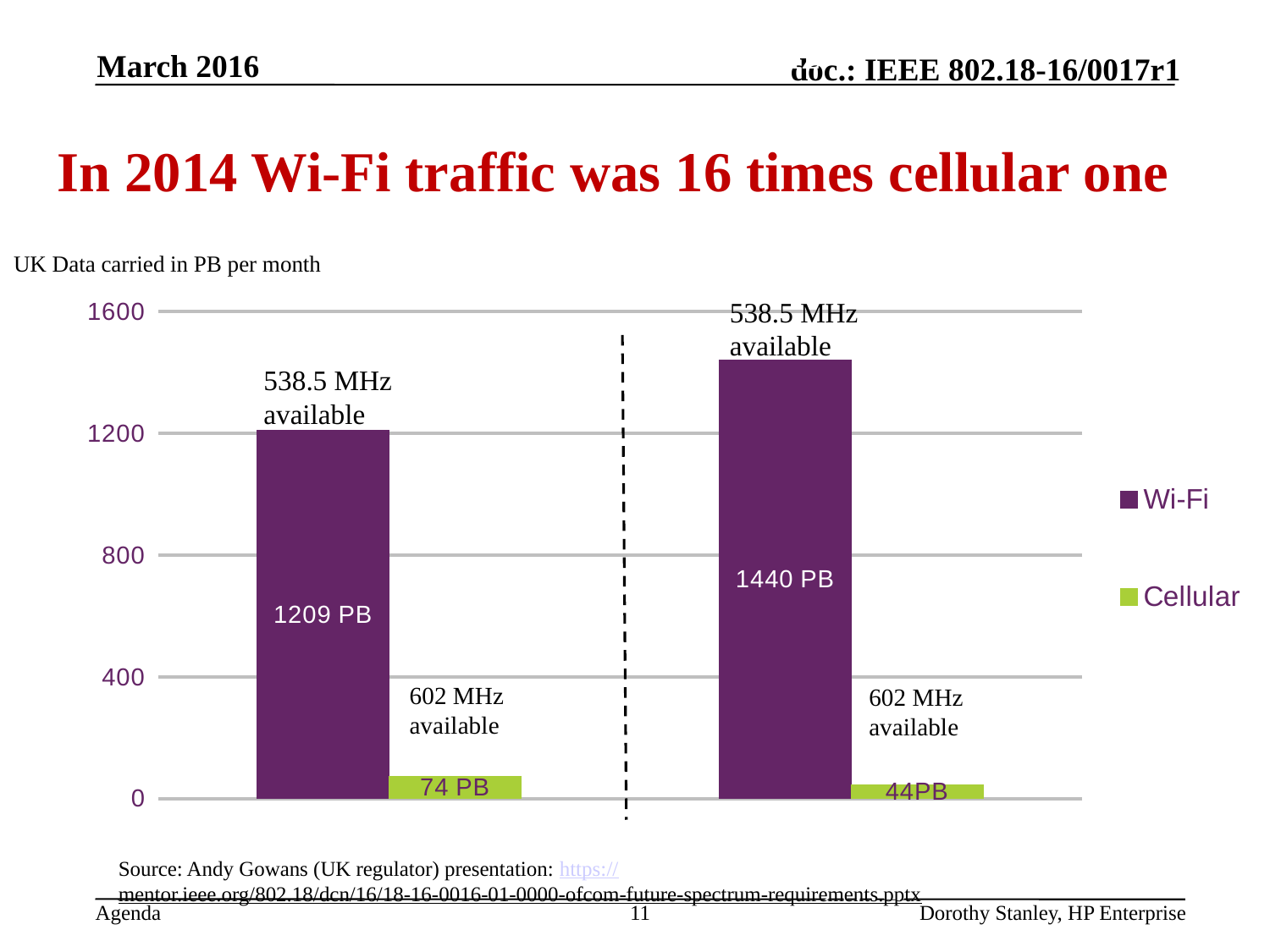
How many series does the chart legend list? 2 Is the Wi-Fi value in the left group greater or less than 1200? greater What is the Wi-Fi value shown on the left group of bars? 1209 PB What is the Wi-Fi value shown on the right group of bars? 1440 PB What are the two series named in the chart legend? Wi-Fi and Cellular Which bar in the chart has the highest value? Wi-Fi in the right group (1440 PB) What is the difference between the Wi-Fi values of the right group and the left group? 231 PB What is the Cellular value shown on the left group of bars? 74 PB Which bar in the chart has the lowest value? Cellular in the right group (44PB) What type of chart is shown on the slide? bar chart What is the Cellular value shown on the right group of bars? 44PB Which is larger, the Cellular value in the left group or the Cellular value in the right group? left group (74 PB)